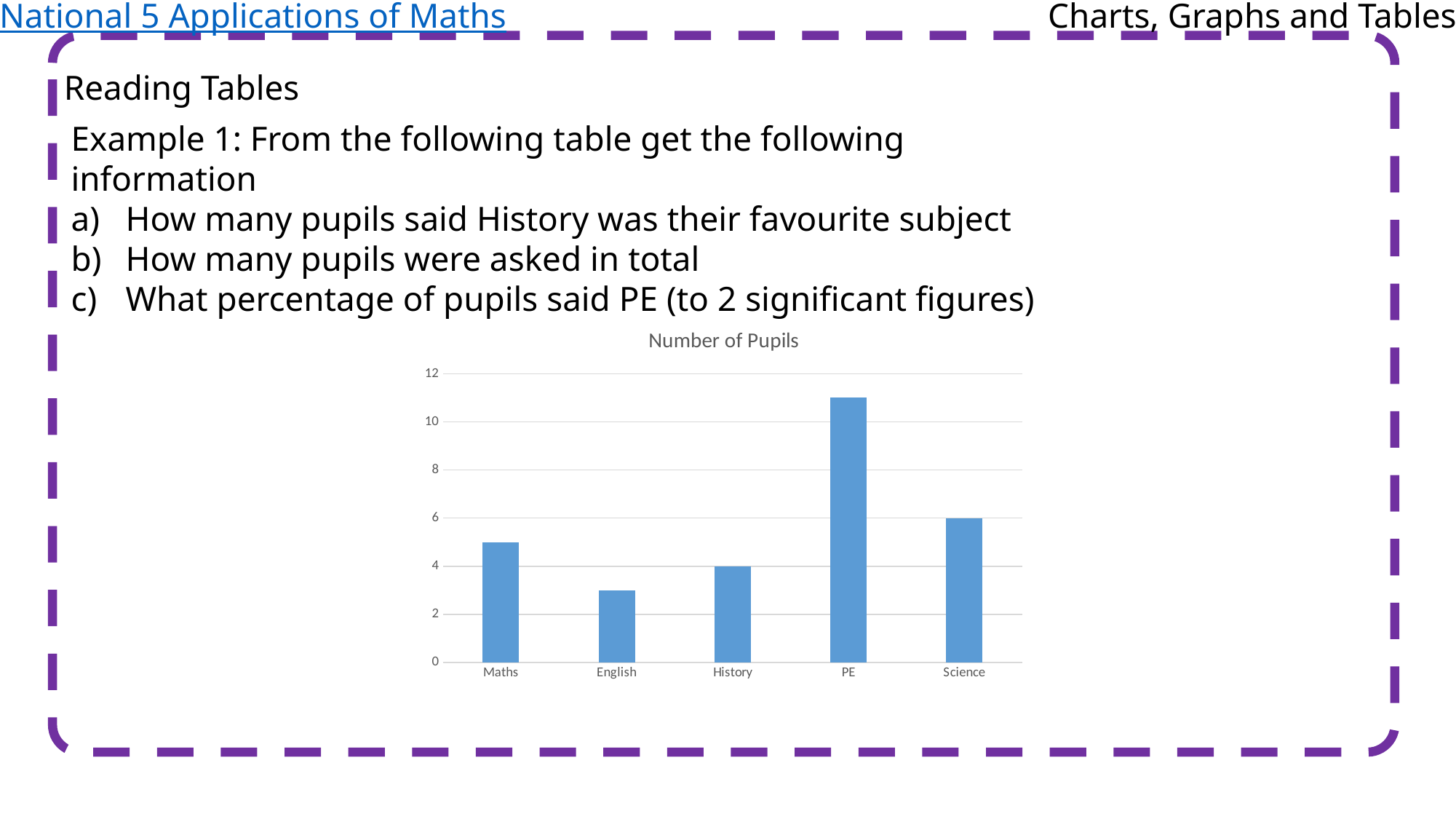
What is the number of pupils for Science? 6 Is the value for PE greater or less than 10? greater Which subject has the lowest number of pupils? English Which has more pupils, Science or History? Science How many subjects are shown on the x axis of the chart? 5 Which subject has the highest number of pupils? PE What is the difference between the number of pupils for Science and for History? 2 What is the title of the chart? Number of Pupils Is the value for English greater or less than 4? less What is the number of pupils for History? 4 Is the value for Maths greater or less than 4? greater What type of chart is shown on the slide? bar chart